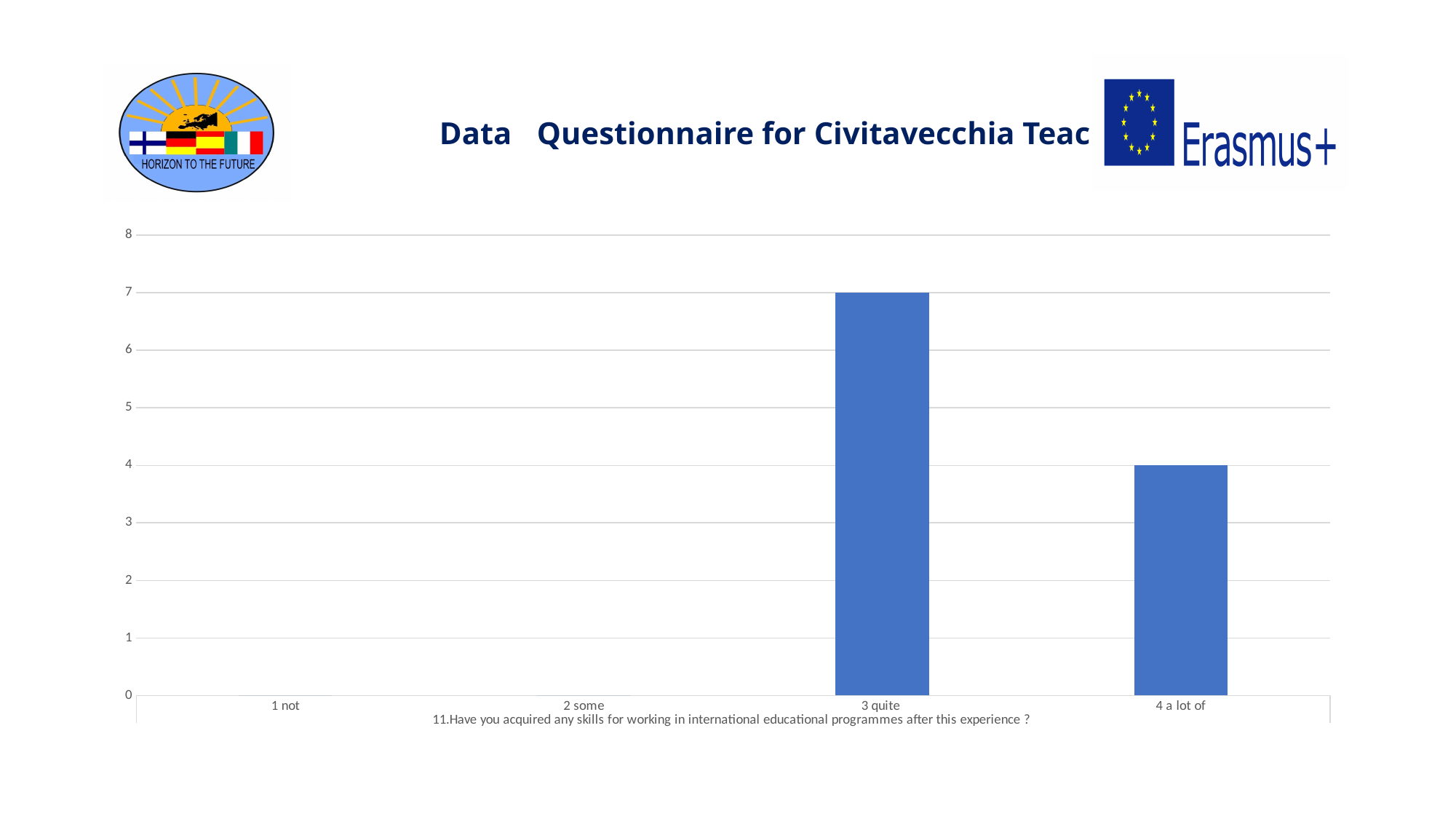
Which category has the highest value? 3 quite Is the value for "4 a lot of" greater or less than 6? less Which categories show no bar at all? 1 not and 2 some What is the highest value shown on the vertical axis? 8 Which is larger, the value for "3 quite" or the value for "4 a lot of"? 3 quite How many categories are shown on the x axis? 4 What is the difference between the values for "3 quite" and "4 a lot of"? 3 What question number is written below the x axis categories? 11 What is the value for the category "4 a lot of"? 4 Is the value for "3 quite" greater or less than 5? greater What kind of chart is shown on the slide? bar chart What is the value for the category "3 quite"? 7